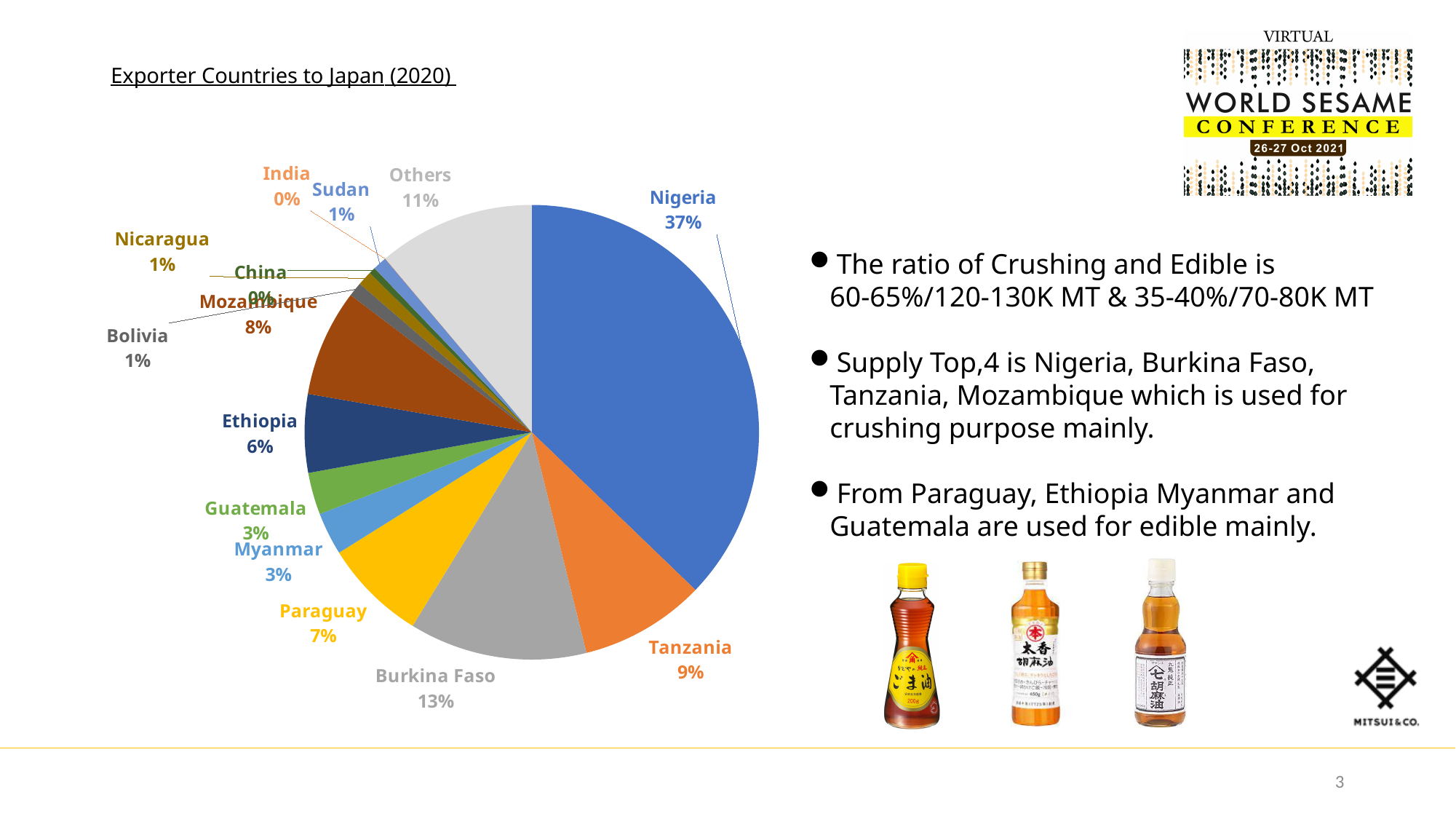
What is the difference in percentage points between Tanzania and Paraguay? 2 Which has a larger share, Ethiopia or Mozambique? Mozambique What type of chart is shown on the slide? pie chart What percentage is shown for Mozambique? 8% What is the title of the chart? Exporter Countries to Japan (2020) How many slices does the pie chart have? 14 What percentage is shown for Burkina Faso? 13% What share of the pie does Nigeria account for? 37% What percentage is shown for Others? 11% Which has a larger share, Tanzania or Paraguay? Tanzania Which country has the largest slice of the pie? Nigeria What is the difference in percentage points between Nigeria and Burkina Faso? 24